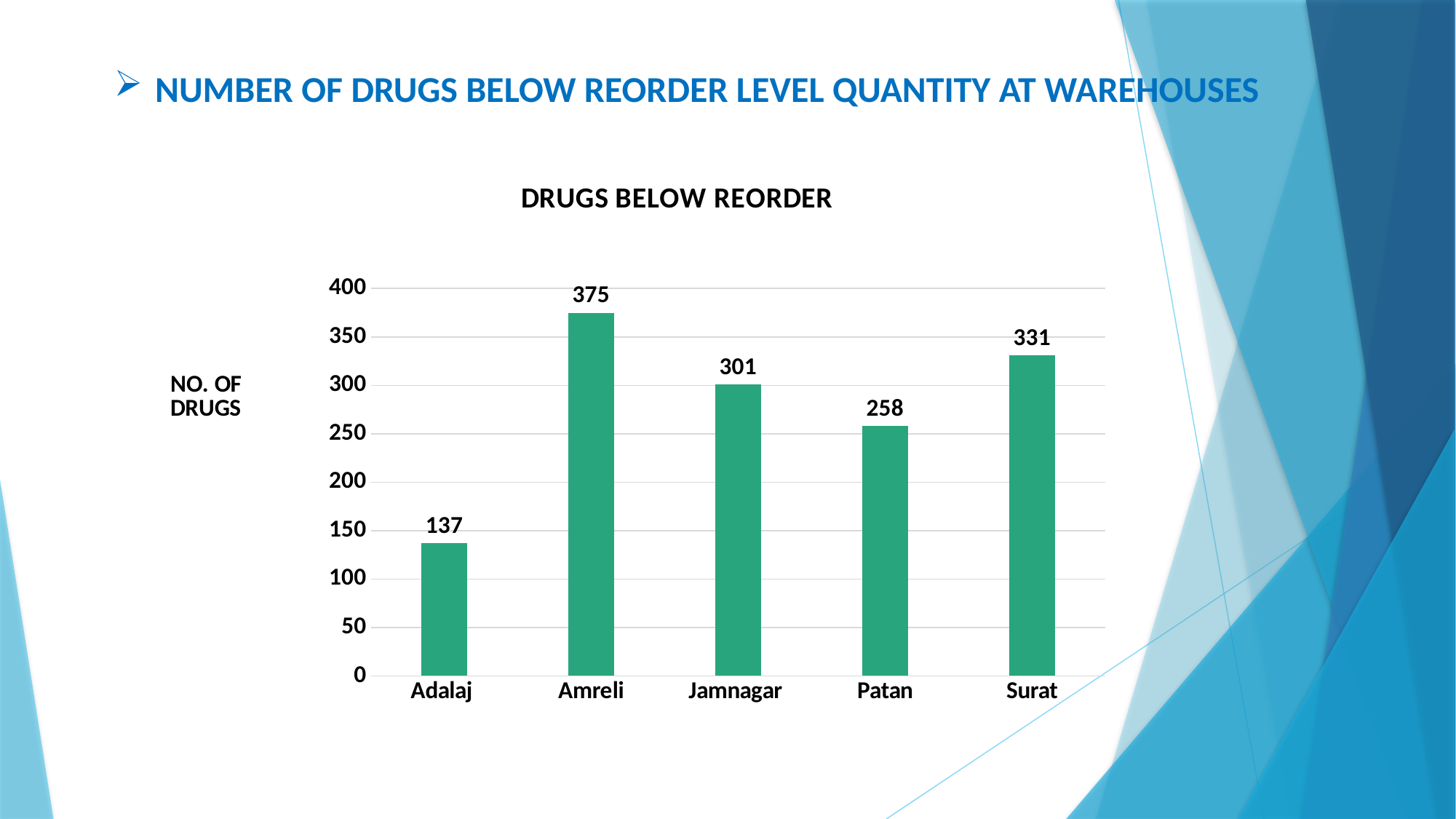
What is the number of drugs below reorder level at Amreli? 375 Which warehouse has the highest number of drugs below reorder level? Amreli What is the difference between the values for Surat and Jamnagar? 30 What is the number of drugs below reorder level at Adalaj? 137 How many warehouses are shown on the x axis of the chart? 5 What is the number of drugs below reorder level at Patan? 258 What is the title of the chart? DRUGS BELOW REORDER What kind of chart is shown on the slide? bar chart Which warehouse has the lowest number of drugs below reorder level? Adalaj What is the difference between the values for Amreli and Adalaj? 238 Which has a larger value, Jamnagar or Patan? Jamnagar Is the value for Surat greater or less than 300? greater